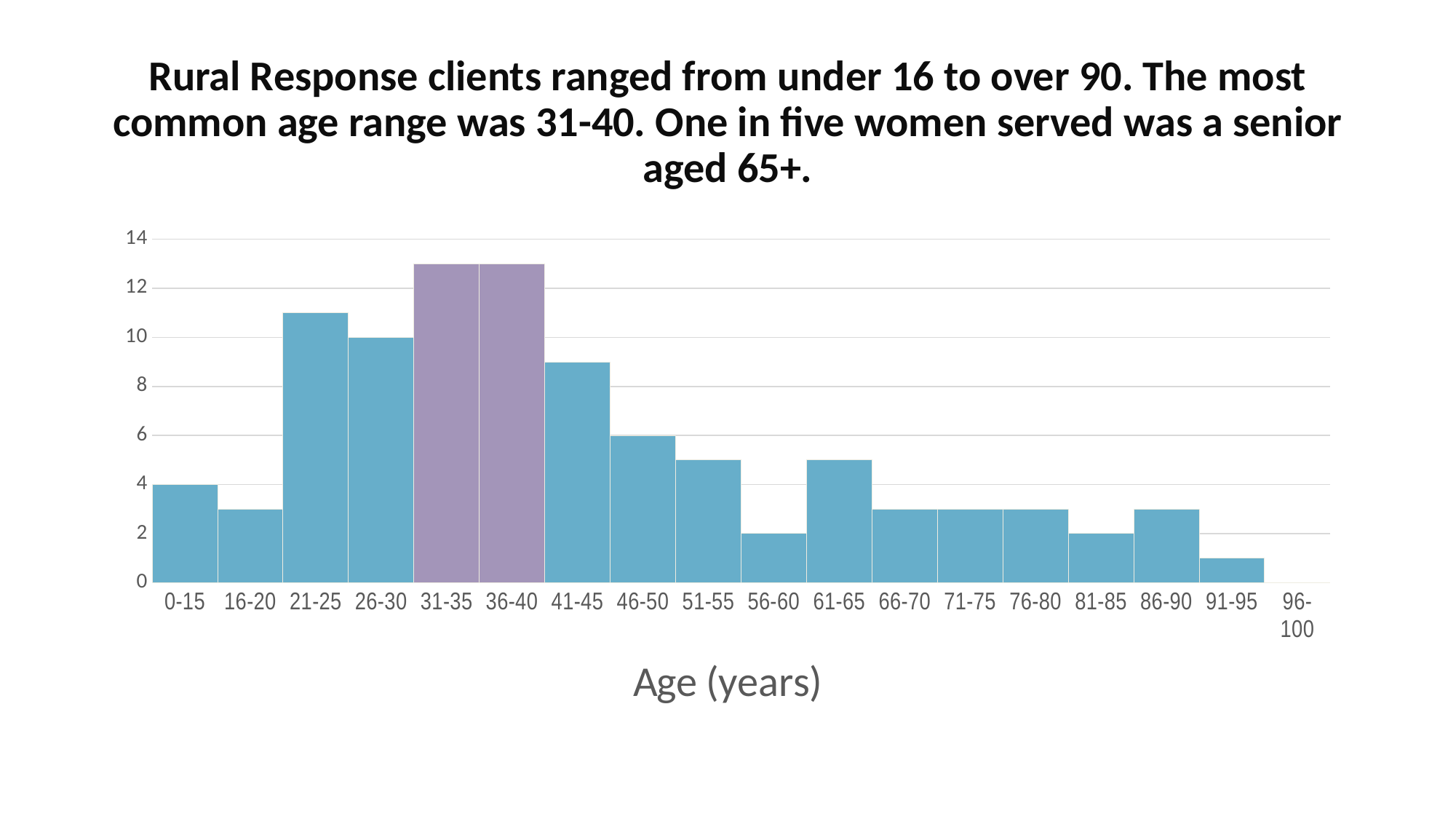
Is the value for the 21-25 age group greater or less than 10? greater What is the difference between the values for the 26-30 and 0-15 age groups? 6 What kind of chart is shown on the slide? bar chart How many age groups are shown on the x axis? 18 Which age group has the lowest value? 96-100 Which has the larger value, the 41-45 age group or the 46-50 age group? 41-45 What is the value for the 0-15 age group? 4 What is the value for the 26-30 age group? 10 What is the value for the 46-50 age group? 6 What is the value for the 56-60 age group? 2 Is the value for the 91-95 age group greater or less than 2? less What is the x-axis title of the chart? Age (years)